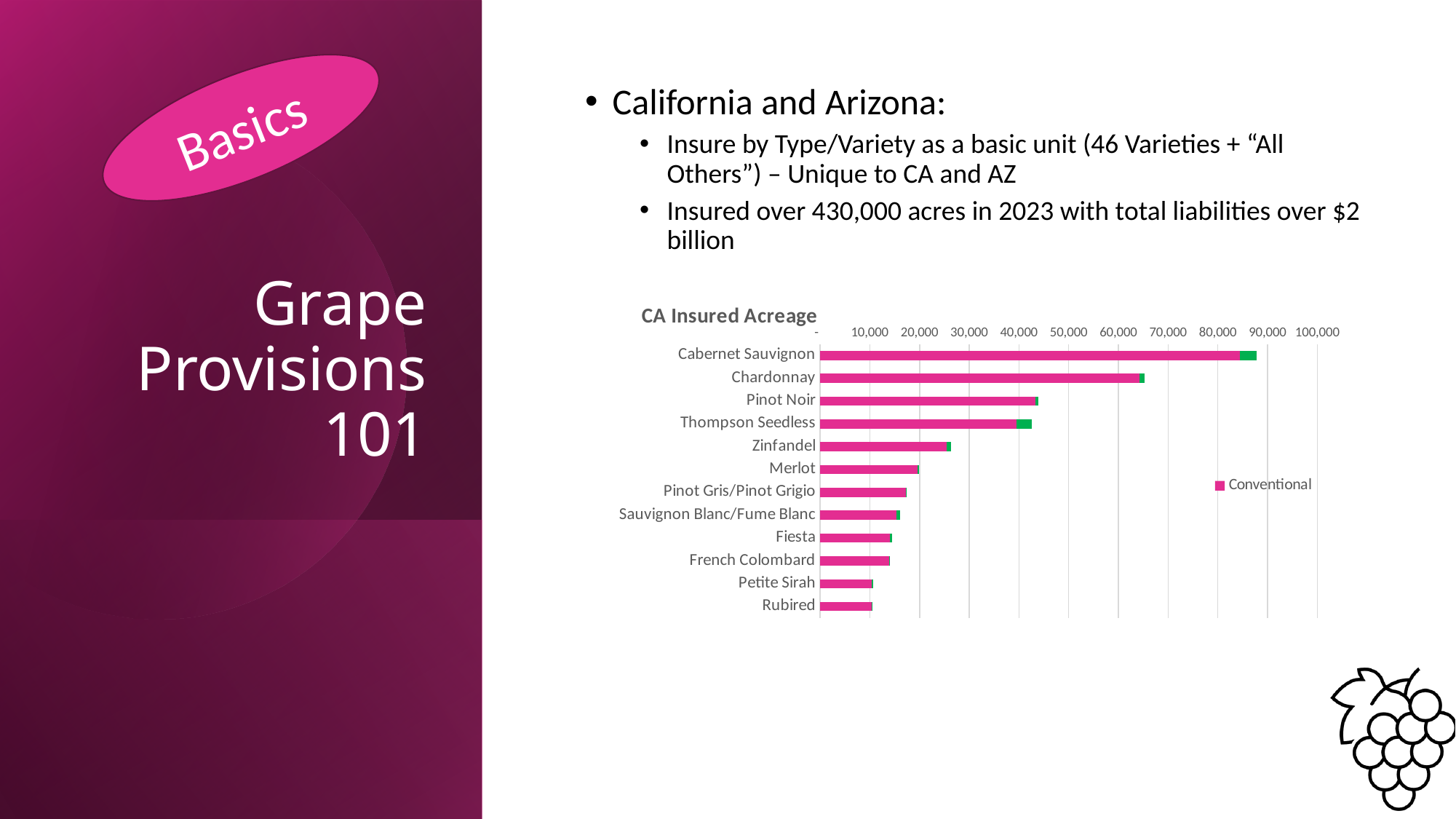
Is the insured acreage for Pinot Gris/Pinot Grigio greater or less than 20,000? less Is the insured acreage for Chardonnay greater or less than 60,000? greater Do the bars on the CA Insured Acreage chart get longer or shorter going from the top variety to the bottom variety? shorter What kind of chart is shown under the title "CA Insured Acreage"? bar chart Which variety has the highest insured acreage on the CA Insured Acreage chart? Cabernet Sauvignon Is the insured acreage for Zinfandel greater or less than 30,000? less How many grape varieties are listed on the CA Insured Acreage chart? 12 What series name is shown in the legend of the CA Insured Acreage chart? Conventional Which has more insured acreage, Merlot or French Colombard? Merlot Which has more insured acreage, Pinot Noir or Zinfandel? Pinot Noir